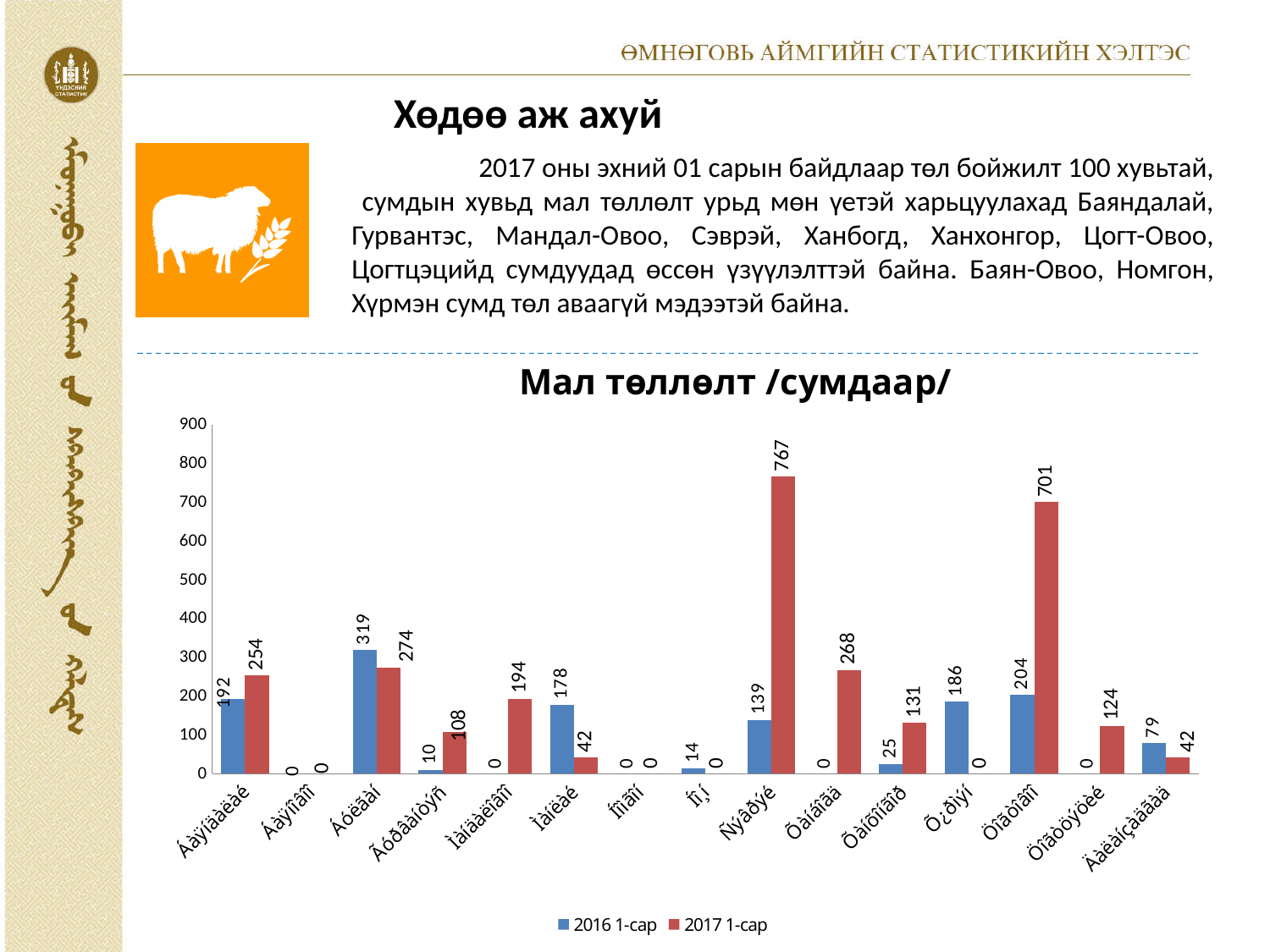
What kind of chart is shown under the title "Мал төллөлт /сумдаар/"? bar chart How many series does the legend of the "Мал төллөлт /сумдаар/" chart list? 2 What is the highest value shown in the "2017 1-сар" series? 767 What is the highest value shown in the "2016 1-сар" series? 319 For the leftmost category, what is the difference between the "2017 1-сар" and "2016 1-сар" values? 62 What are the two legend entries of the "Мал төллөлт /сумдаар/" chart? 2016 1-сар and 2017 1-сар For the leftmost category on the chart, what is the "2016 1-сар" value? 192 Is the tallest bar on the chart greater or less than 700? greater How many categories are plotted along the x axis of the "Мал төллөлт /сумдаар/" chart? 15 For the leftmost category on the chart, what is the "2017 1-сар" value? 254 Which colour represents the "2017 1-сар" series in the chart? red What is the highest value labelled anywhere on the "Мал төллөлт /сумдаар/" chart? 767